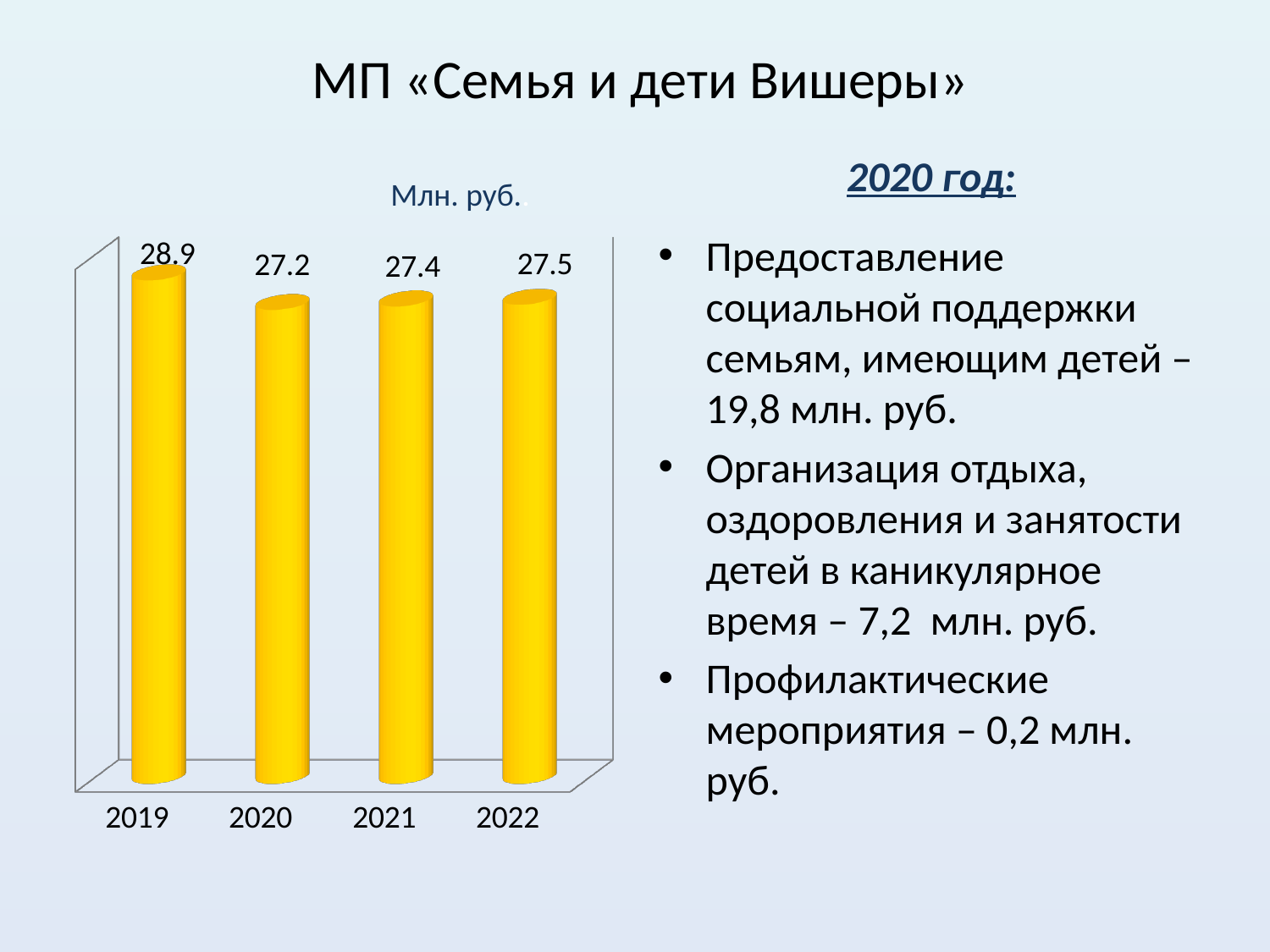
What is the difference between the values for 2022 and 2021? 0.1 What is the value for 2019? 28.9 How many years are shown on the chart? 4 What is the value for 2022? 27.5 What is the title of the chart? Млн. руб. Which year has the highest value? 2019 What is the value for 2020? 27.2 What is the value for 2021? 27.4 What kind of chart is shown on the slide? bar chart What is the difference between the values for 2019 and 2020? 1.7 Which is larger, the value for 2019 or the value for 2022? 2019 Which year has the lowest value? 2020